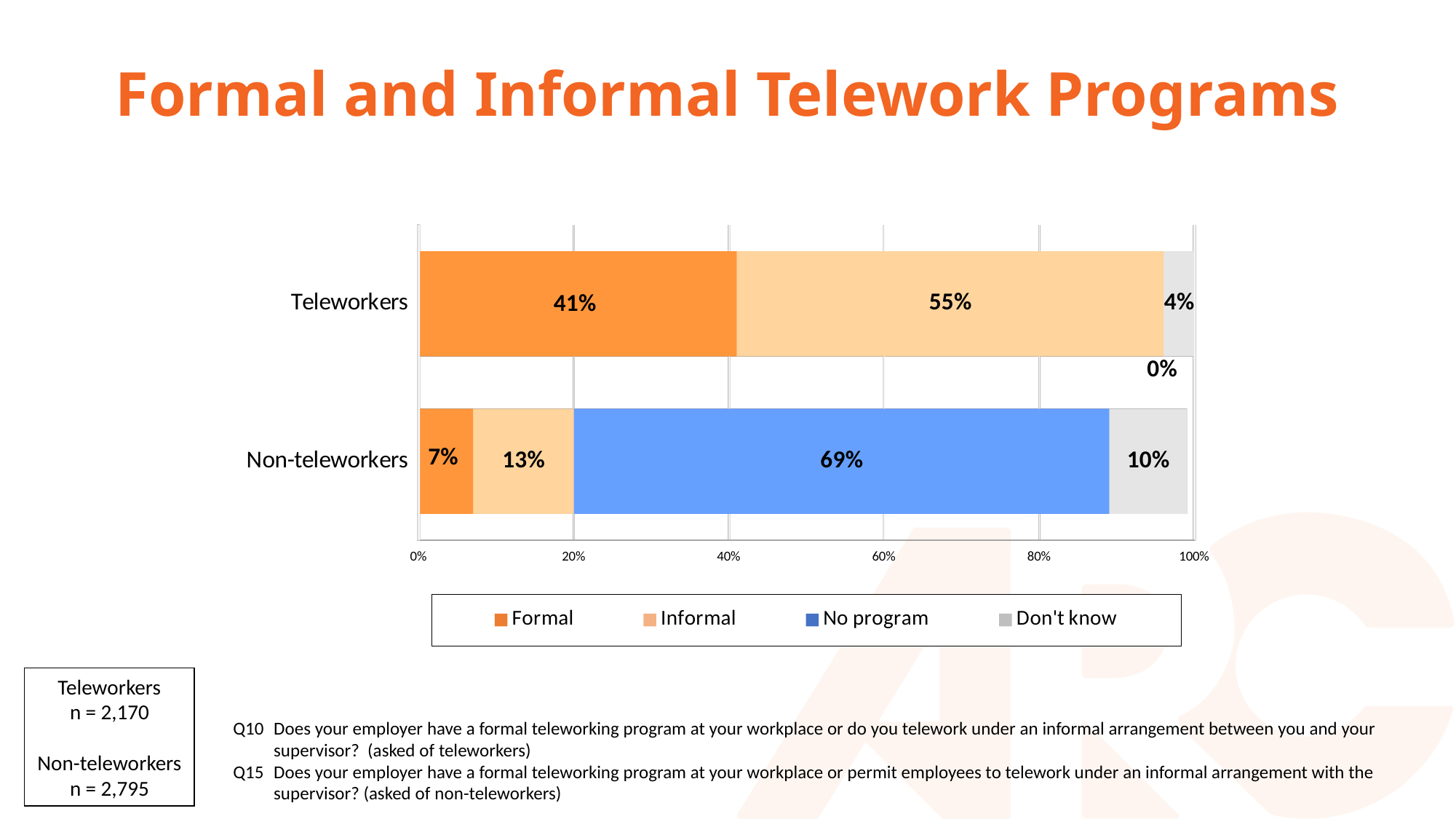
What percentage of Non-teleworkers answered Don't know? 10% What percentage of Teleworkers report a Formal telework program? 41% What type of chart is shown on the slide? Stacked bar chart Which colour represents the No program series in the legend? Blue What percentage of Non-teleworkers report a Formal telework program? 7% What percentage of Teleworkers report an Informal telework arrangement? 55% What is the difference between the Informal and Formal percentages for Non-teleworkers? 6% How many series does the legend list? 4 Which segment is the largest in the Non-teleworkers bar? No program What is the difference between the Formal percentage for Teleworkers and for Non-teleworkers? 34% What percentage of Non-teleworkers report No program? 69% Which group has the higher Informal percentage, Teleworkers or Non-teleworkers? Teleworkers